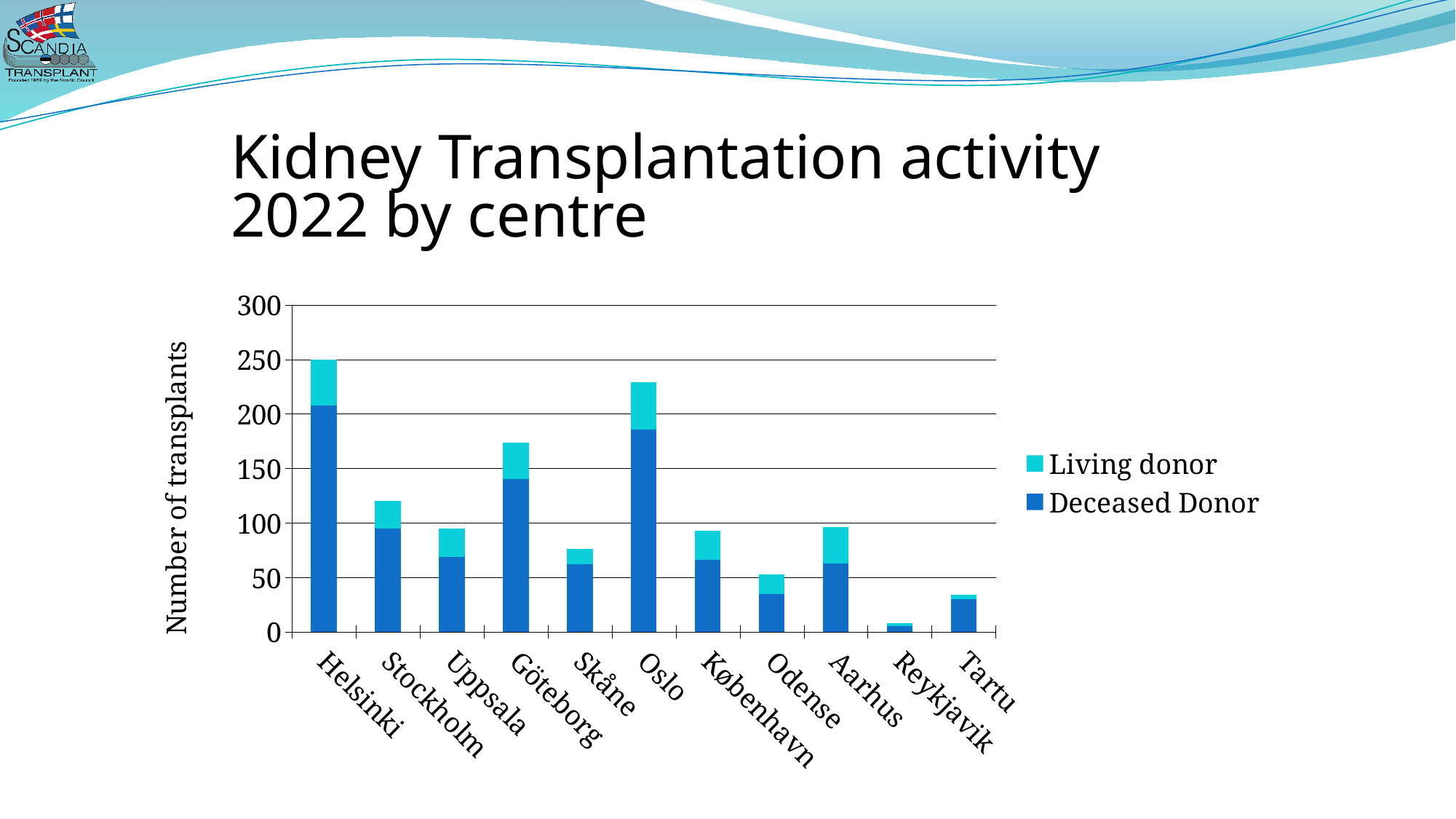
Is the total number of transplants for Oslo greater or less than 200? greater Which centre has the highest total number of transplants? Helsinki Which centre has the lowest total number of transplants? Reykjavik Is the total number of transplants for Skåne greater or less than 100? less How many centres are shown on the x axis of the chart? 11 Is the total number of transplants for Tartu greater or less than 50? less What kind of chart is shown on the slide? stacked bar chart Which centre has a larger total number of transplants, Göteborg or Stockholm? Göteborg What is the label of the y axis of the chart? Number of transplants How many series does the chart's legend list? 2